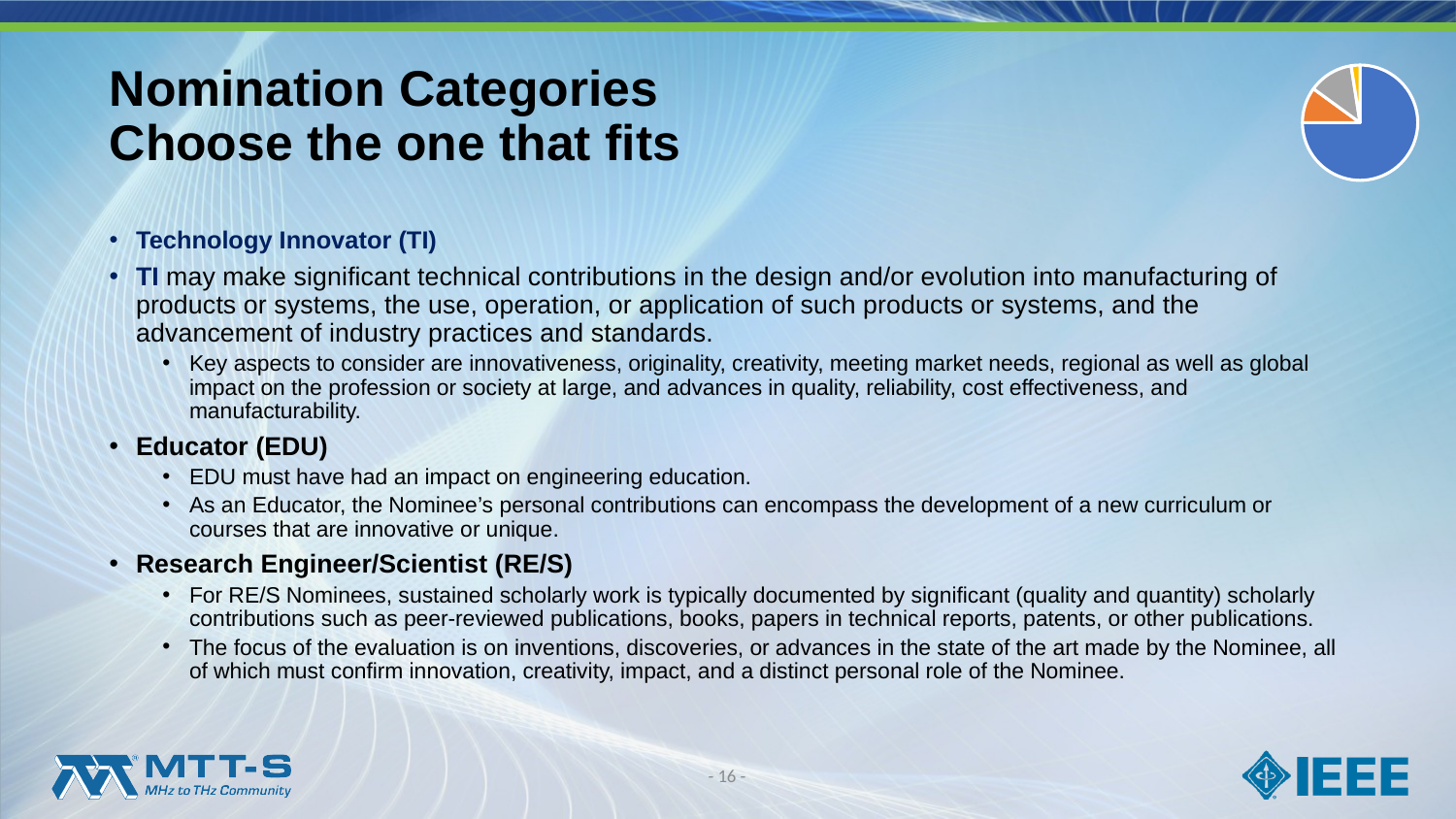
How many slices does the pie chart in the top right corner have? 4 In the pie chart in the top right corner, is the gray slice larger or smaller than the blue slice? smaller What kind of chart is shown in the top right corner of the slide? pie chart In the pie chart in the top right corner, is the blue slice larger or smaller than the orange slice? larger Which colour slice is the largest in the pie chart in the top right corner? blue Does the pie chart in the top right corner show a legend? No